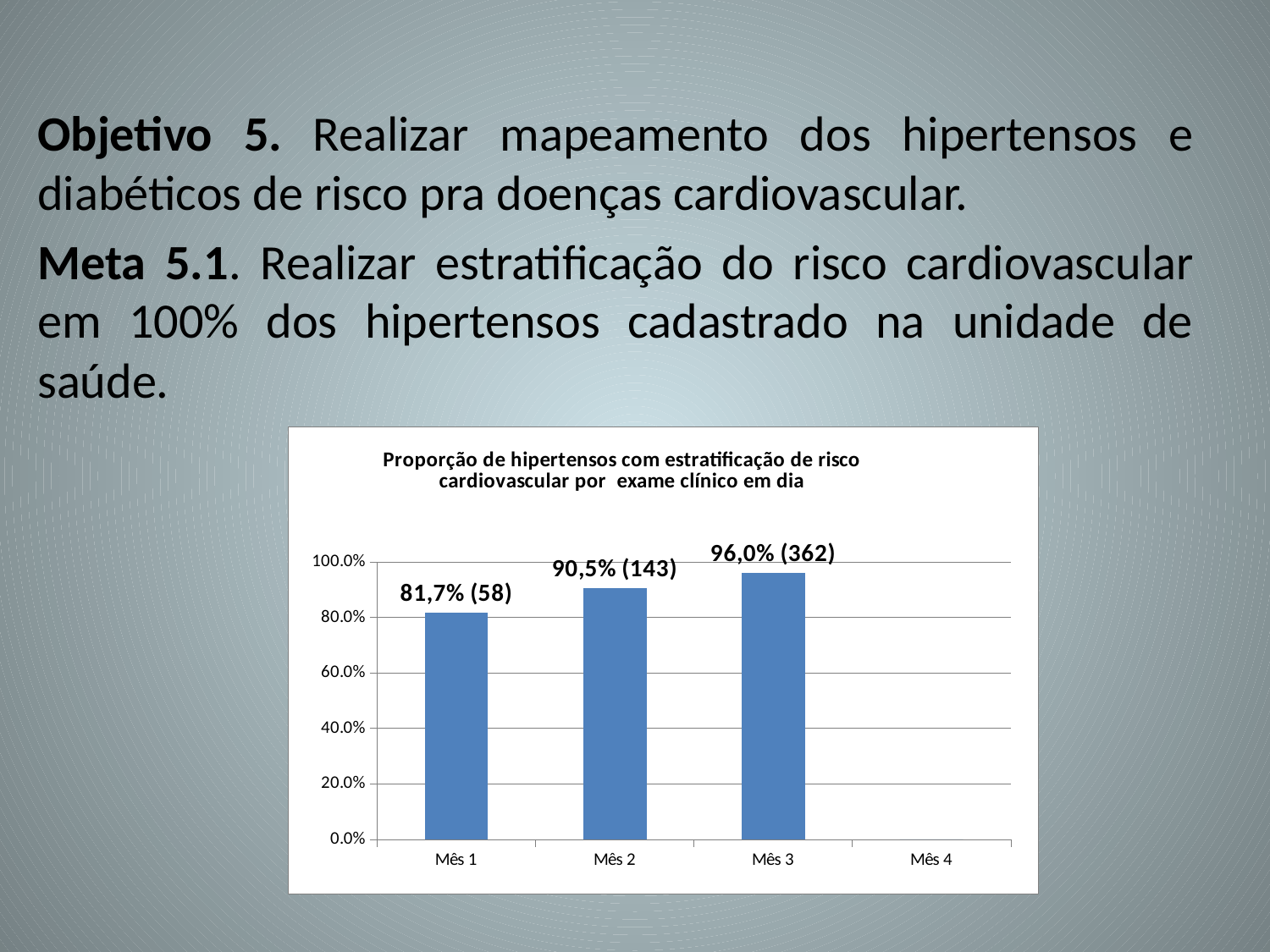
What is the difference in percentage points between Mês 2 and Mês 1? 8,8 What is the difference in percentage points between Mês 3 and Mês 1? 14,3 How many month categories are shown on the x axis? 4 Among the months with a plotted bar, which has the lowest proportion? Mês 1 What is the value shown for Mês 3? 96,0% (362) What is the value shown for Mês 1? 81,7% (58) Which is larger, the proportion for Mês 2 or for Mês 3? Mês 3 Is the value for Mês 2 greater or less than 80.0%? greater Which month has the highest proportion? Mês 3 What kind of chart is shown on the slide? Bar chart Do the values rise or fall from Mês 1 to Mês 3? Rise What is the value shown for Mês 2? 90,5% (143)